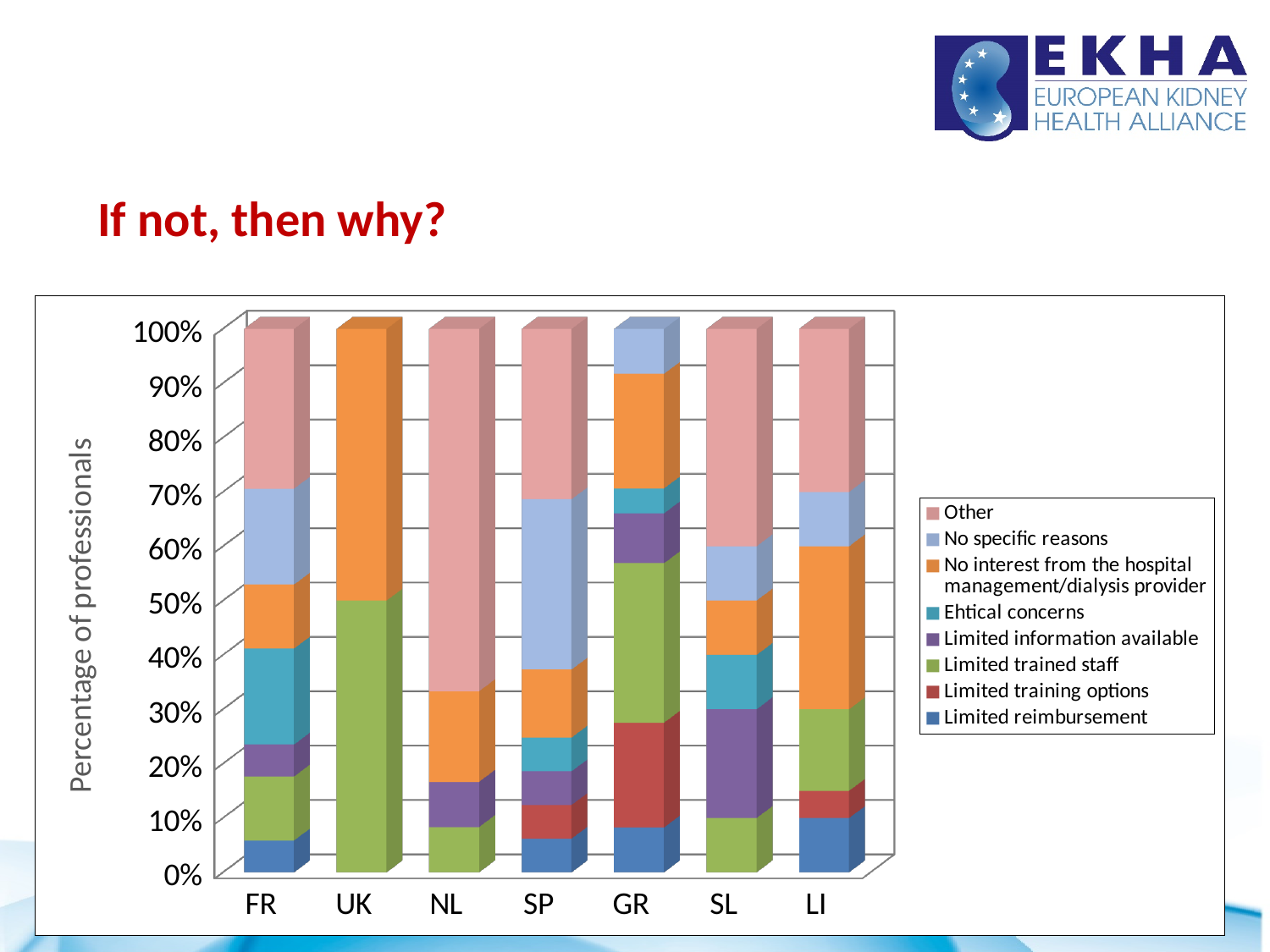
Is the value for 'No interest from the hospital management/dialysis provider' in LI greater or less than 20%? greater Which country has the largest share for 'Limited trained staff'? UK Is the value for 'Limited information available' in SL greater or less than 10%? greater What is the title of the vertical axis of the chart? Percentage of professionals Is the value for 'Other' in FR greater or less than 20%? greater How many series does the chart's legend list? 8 Which country has the largest share for 'Other'? NL Which legend entry is listed first (at the top) in the chart's legend? Other What kind of chart is shown on the slide? Stacked bar chart How many countries are shown along the x axis of the chart? 7 Which is larger, the 'Other' share for NL or the 'Other' share for FR? NL